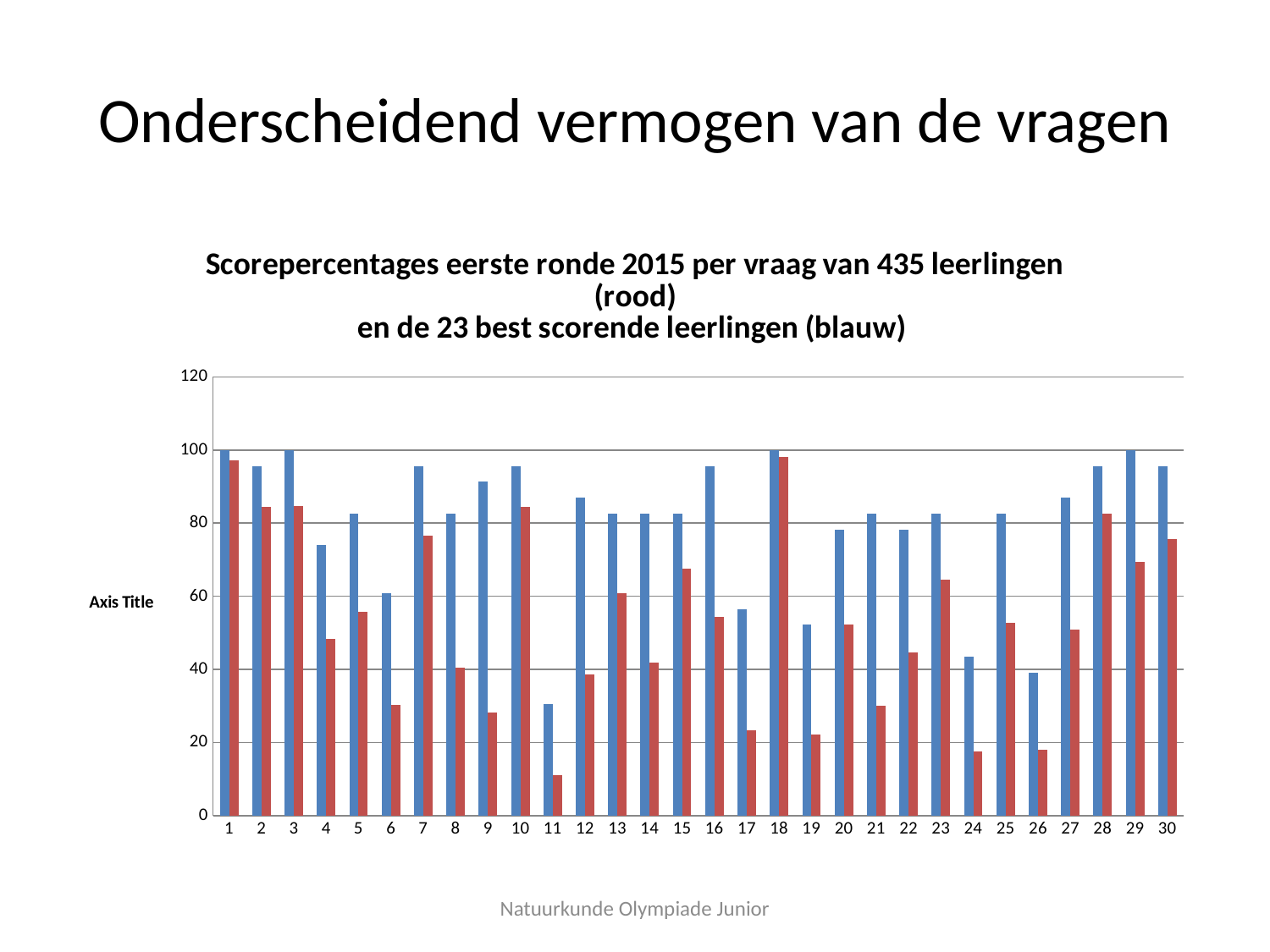
What kind of chart is shown on the slide? bar chart Is the value of the blue bar for question 4 greater or less than 80? less What is the label shown on the vertical axis of the chart? Axis Title For which question is the blue bar the lowest? 11 Is the value of the red bar for question 18 greater or less than 80? greater What is the value of the blue bar for question 29? 100 What is the value of the blue bar for question 1? 100 For question 7, which bar is larger, the blue bar or the red bar? blue How many questions (categories) are shown on the x axis of the chart? 30 Which is larger, the red bar for question 6 or the red bar for question 9? question 6 Is the value of the red bar for question 11 greater or less than 20? less For which question is the red bar the lowest? 11